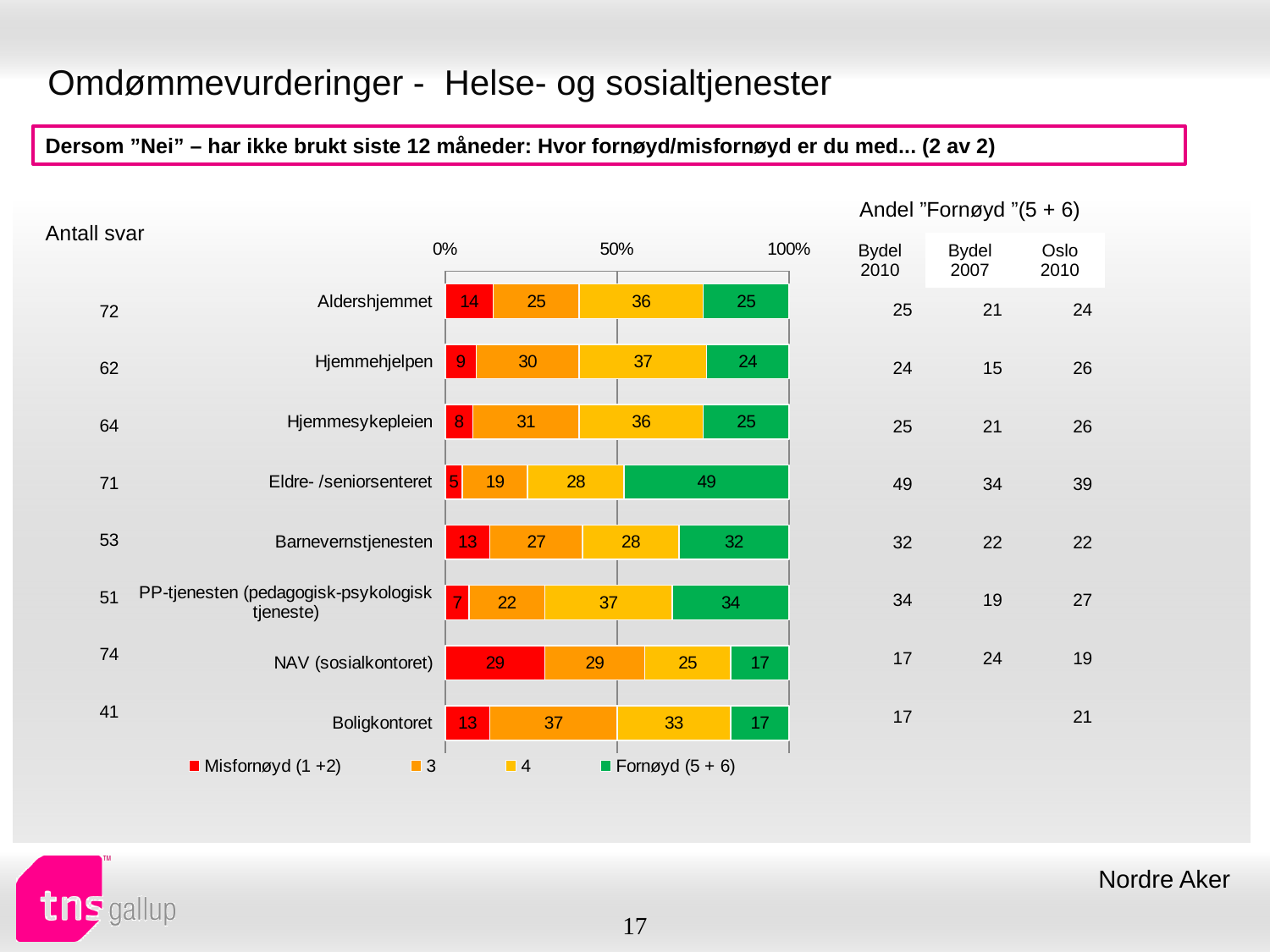
Which category has the highest "Fornøyd (5 + 6)" value? Eldre- /seniorsenteret What is the value of the "Fornøyd (5 + 6)" series for Eldre- /seniorsenteret? 49 Which has the larger "Misfornøyd (1 +2)" value, NAV (sosialkontoret) or Hjemmehjelpen? NAV (sosialkontoret) Which category has the highest "Misfornøyd (1 +2)" value? NAV (sosialkontoret) How many series does the chart legend list? 4 Which category has the lowest "Misfornøyd (1 +2)" value? Eldre- /seniorsenteret What is the value of the "Misfornøyd (1 +2)" series for NAV (sosialkontoret)? 29 What is the value of series "4" for Hjemmesykepleien? 36 What is the difference between the "Fornøyd (5 + 6)" value for Eldre- /seniorsenteret and for NAV (sosialkontoret)? 32 What kind of chart is shown on the slide? Stacked bar chart What is the total of the stacked bar for Aldershjemmet? 100 How many categories are shown in the bar chart? 8